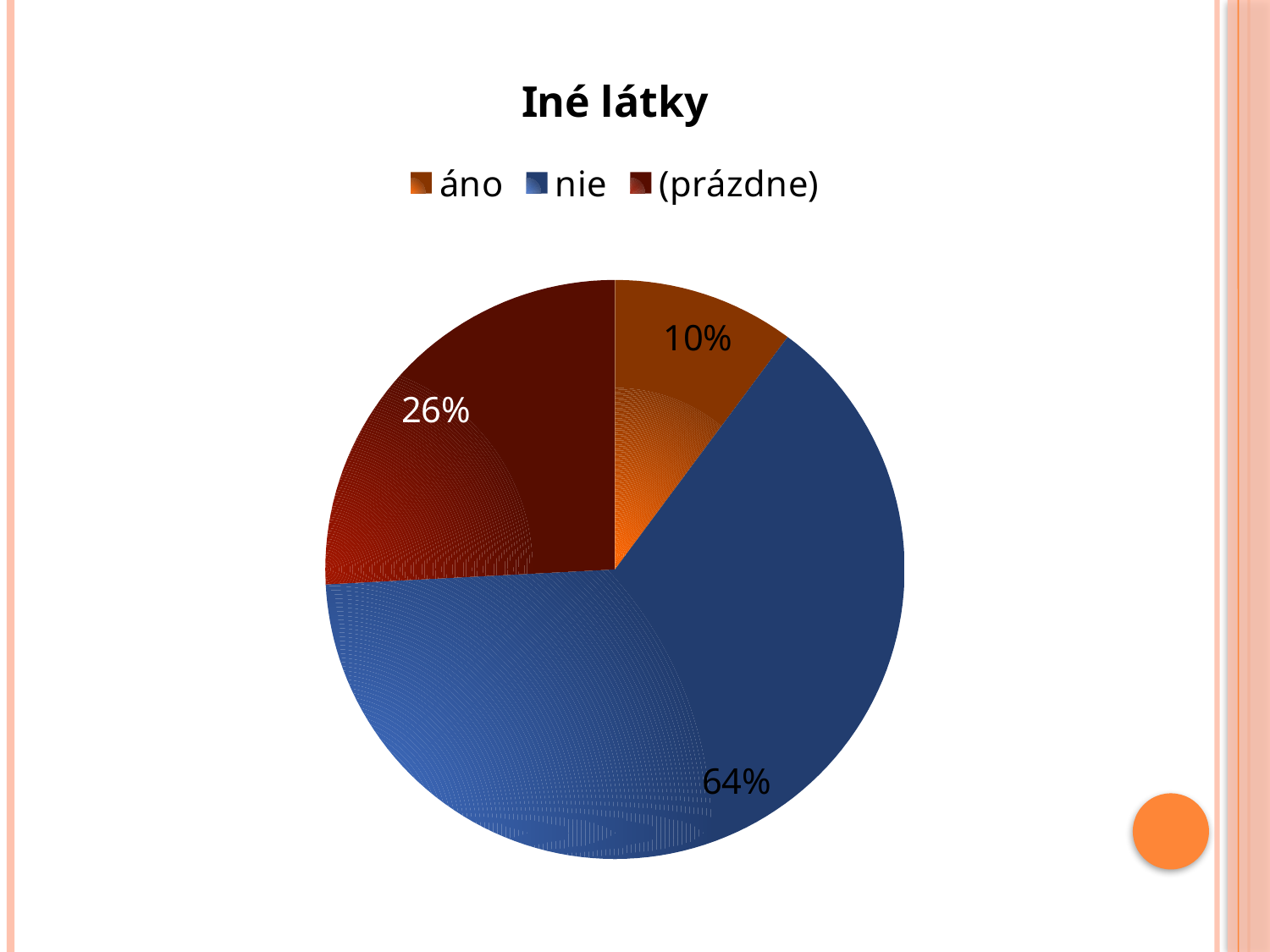
What is the title of the chart? Iné látky What is the difference in percentage points between the '(prázdne)' and 'áno' slices? 16 Which category has the largest slice? nie What share of the pie does the '(prázdne)' slice represent? 26% What share of the pie does the 'nie' slice represent? 64% Which slice is larger, 'áno' or '(prázdne)'? (prázdne) How many slices does the pie chart have? 3 Which category has the smallest slice? áno What is the difference in percentage points between the 'nie' and '(prázdne)' slices? 38 What share of the pie does the 'áno' slice represent? 10% How many categories does the legend list? 3 What type of chart is shown on the slide? pie chart